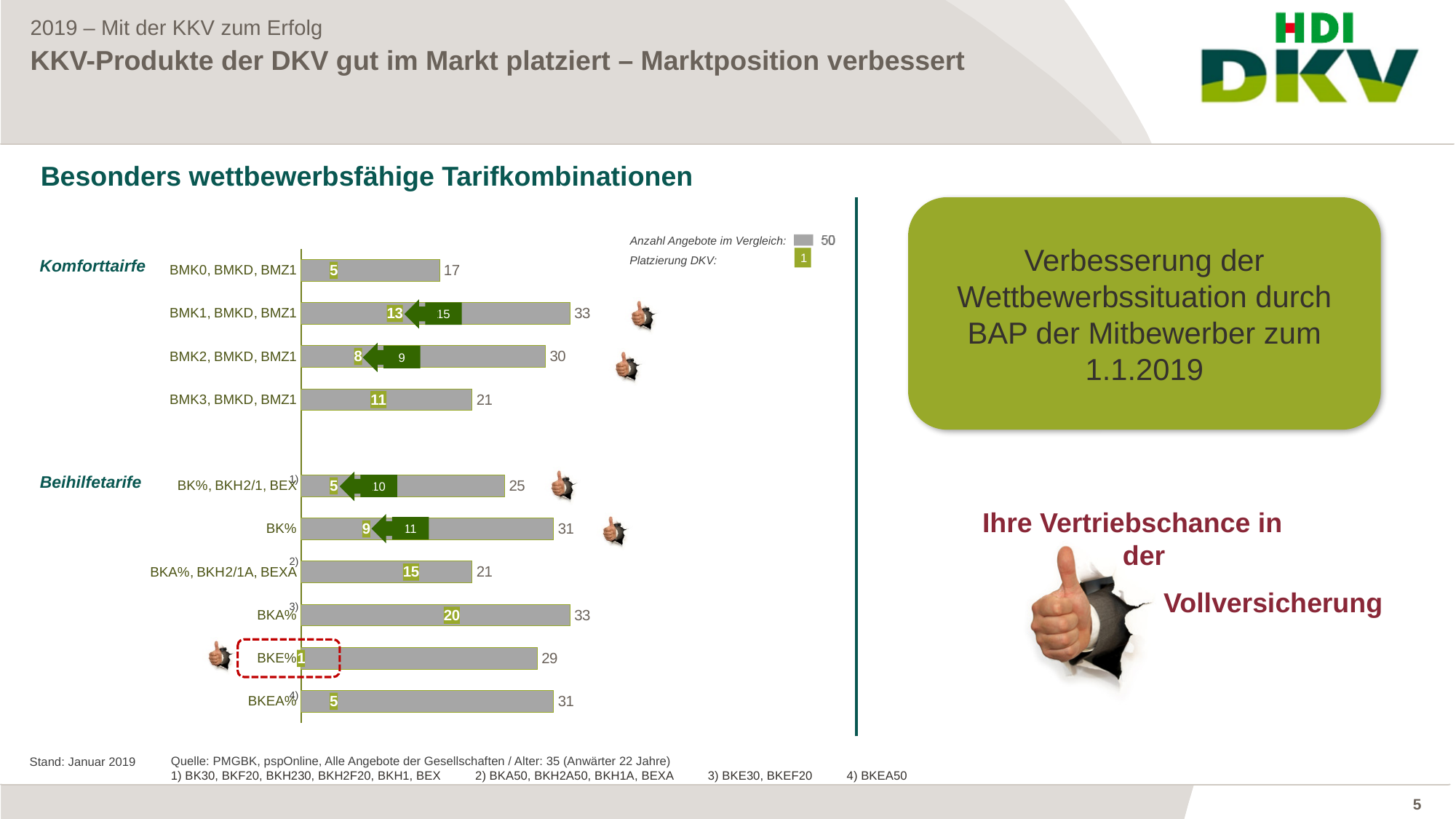
How many entries does the chart legend list? 2 What is the DKV placement for BKA%? 20 What is the DKV placement for BMK3, BMKD, BMZ1? 11 Which category has the lowest number of offers in comparison? BMK0, BMKD, BMZ1 Which has more offers in comparison: BMK2, BMKD, BMZ1 or BMK3, BMKD, BMZ1? BMK2, BMKD, BMZ1 What is the number of offers in comparison for BMK0, BMKD, BMZ1? 17 What is the DKV placement (Platzierung DKV) for BKE%? 1 What type of chart is shown on the slide? Bar chart Which category has the best (lowest) DKV placement? BKE% How many tariff combinations (categories) are shown in the chart? 10 What is the number of offers in comparison (Anzahl Angebote im Vergleich) for BMK1, BMKD, BMZ1? 33 What is the difference in the number of offers in comparison between BK% and BK%, BKH2/1, BEX? 6